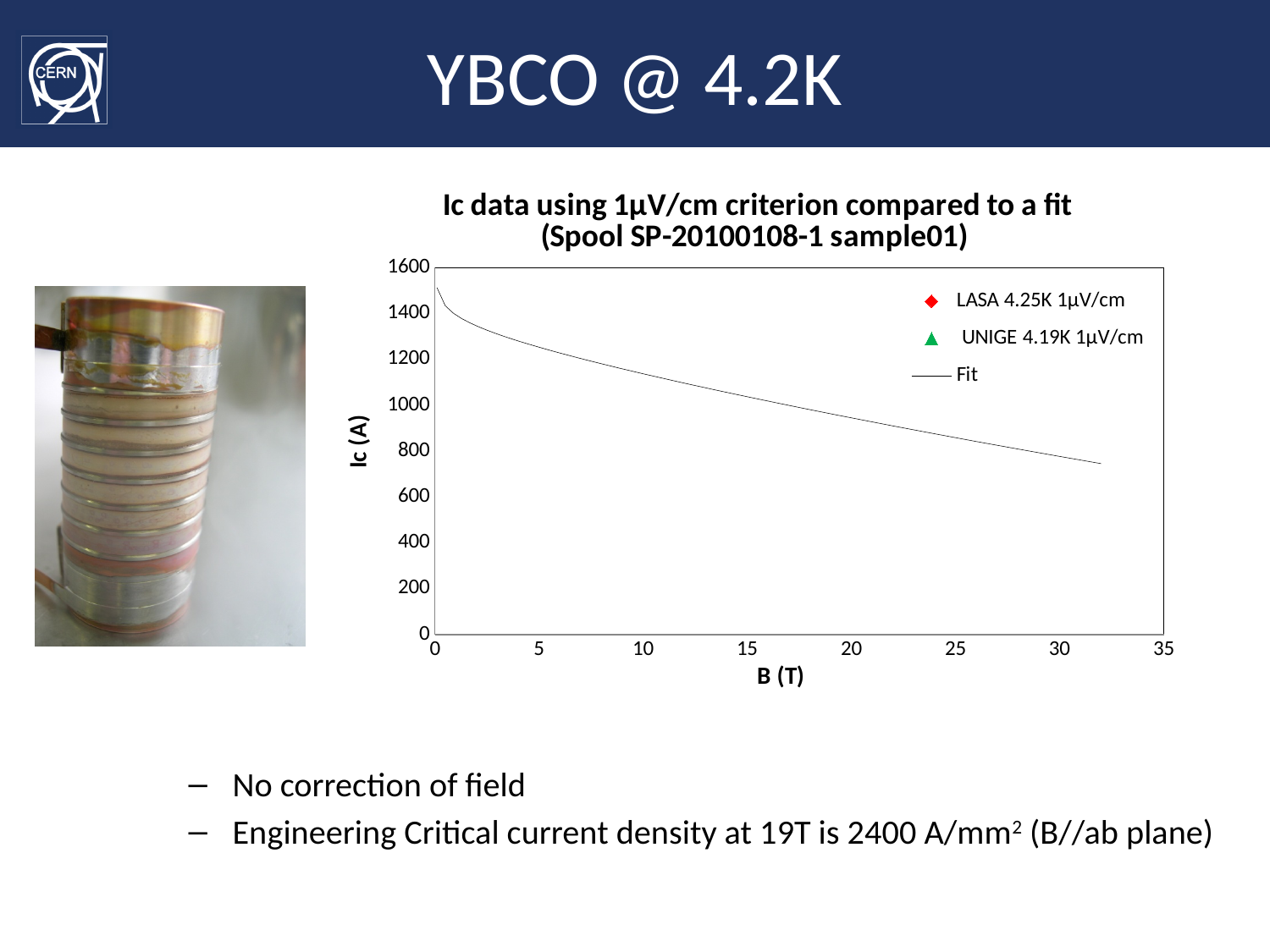
Is the value of the Fit curve at B = 10 T greater or less than 1000? greater Does the Fit curve rise or fall as B increases along the x axis? fall What is the title of the chart? Ic data using 1µV/cm criterion compared to a fit (Spool SP-20100108-1 sample01) Is the value of the Fit curve at B = 25 T greater or less than 1000? less What is the highest value shown on the Ic (A) axis of the chart? 1600 Which is larger on the Fit curve: the value at B = 5 T or the value at B = 30 T? B = 5 T What is the label of the x axis of the chart? B (T) Is the value of the Fit curve at B = 5 T greater or less than 1200? greater What kind of chart is shown on the slide? line chart How many series does the chart legend list? 3